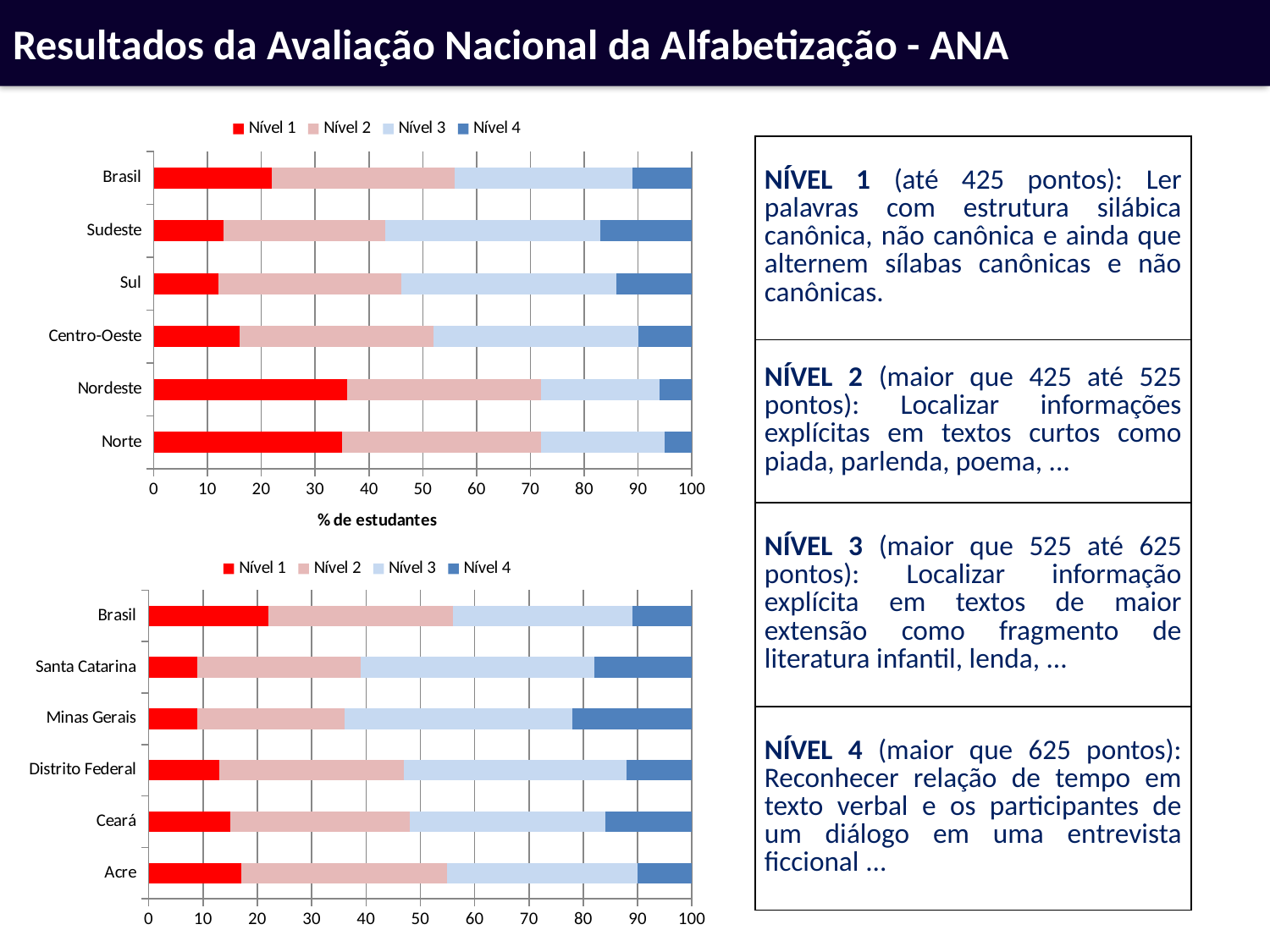
In the bottom chart, is the Nível 1 value for Santa Catarina greater or less than 20? less In the top chart, which has the larger Nível 1 value, Nordeste or Sudeste? Nordeste How many series does the legend of the top chart list? 4 In the bottom chart, which category has the largest Nível 4 segment? Minas Gerais In the top chart, is the Nível 1 value for Nordeste greater or less than 30? greater How many categories are shown on the y axis of the bottom chart? 6 What is the x-axis title of the top chart? % de estudantes In the bottom chart, which category has the highest Nível 1 value? Brasil What kind of chart is the top chart on the slide? Stacked bar chart Which legend entry in the top chart is shown in red? Nível 1 In the top chart, is the Nível 1 value for Sudeste greater or less than 20? less In the bottom chart, which has the larger Nível 1 value, Brasil or Santa Catarina? Brasil